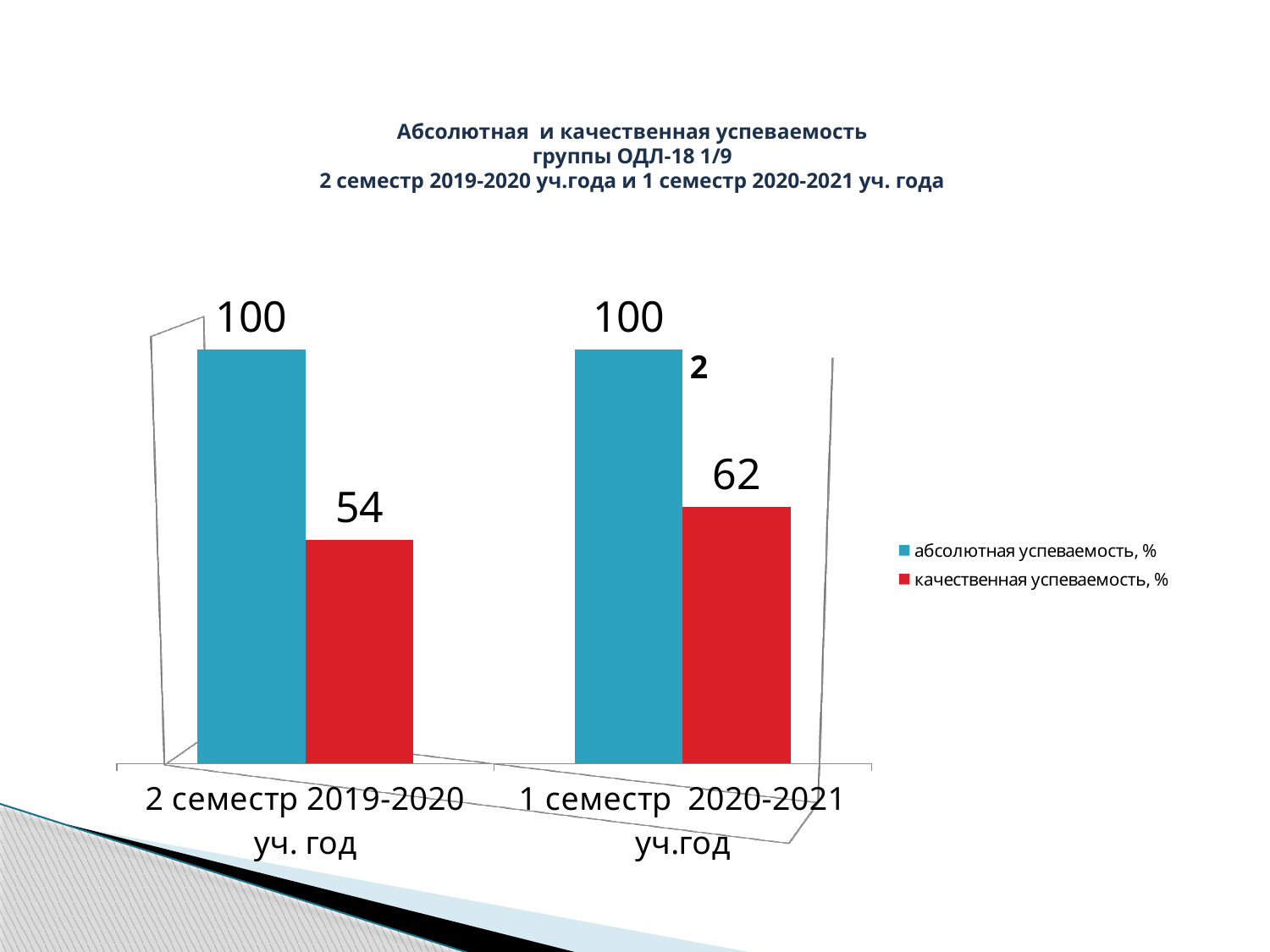
Which is larger in 1 семестр 2020-2021 уч.год: абсолютная успеваемость, % or качественная успеваемость, %? абсолютная успеваемость, % What is the difference between абсолютная успеваемость, % and качественная успеваемость, % in 2 семестр 2019-2020 уч. год? 46 In which semester is качественная успеваемость, % lowest? 2 семестр 2019-2020 уч. год What is the value of качественная успеваемость, % for 2 семестр 2019-2020 уч. год? 54 How many categories are shown on the x axis? 2 In which semester is качественная успеваемость, % highest? 1 семестр 2020-2021 уч.год What is the difference between качественная успеваемость, % in 1 семестр 2020-2021 уч.год and 2 семестр 2019-2020 уч. год? 8 What is the value of абсолютная успеваемость, % for 2 семестр 2019-2020 уч. год? 100 How many series does the legend list? 2 What kind of chart is shown on the slide? bar chart What is the value of абсолютная успеваемость, % for 1 семестр 2020-2021 уч.год? 100 What is the value of качественная успеваемость, % for 1 семестр 2020-2021 уч.год? 62